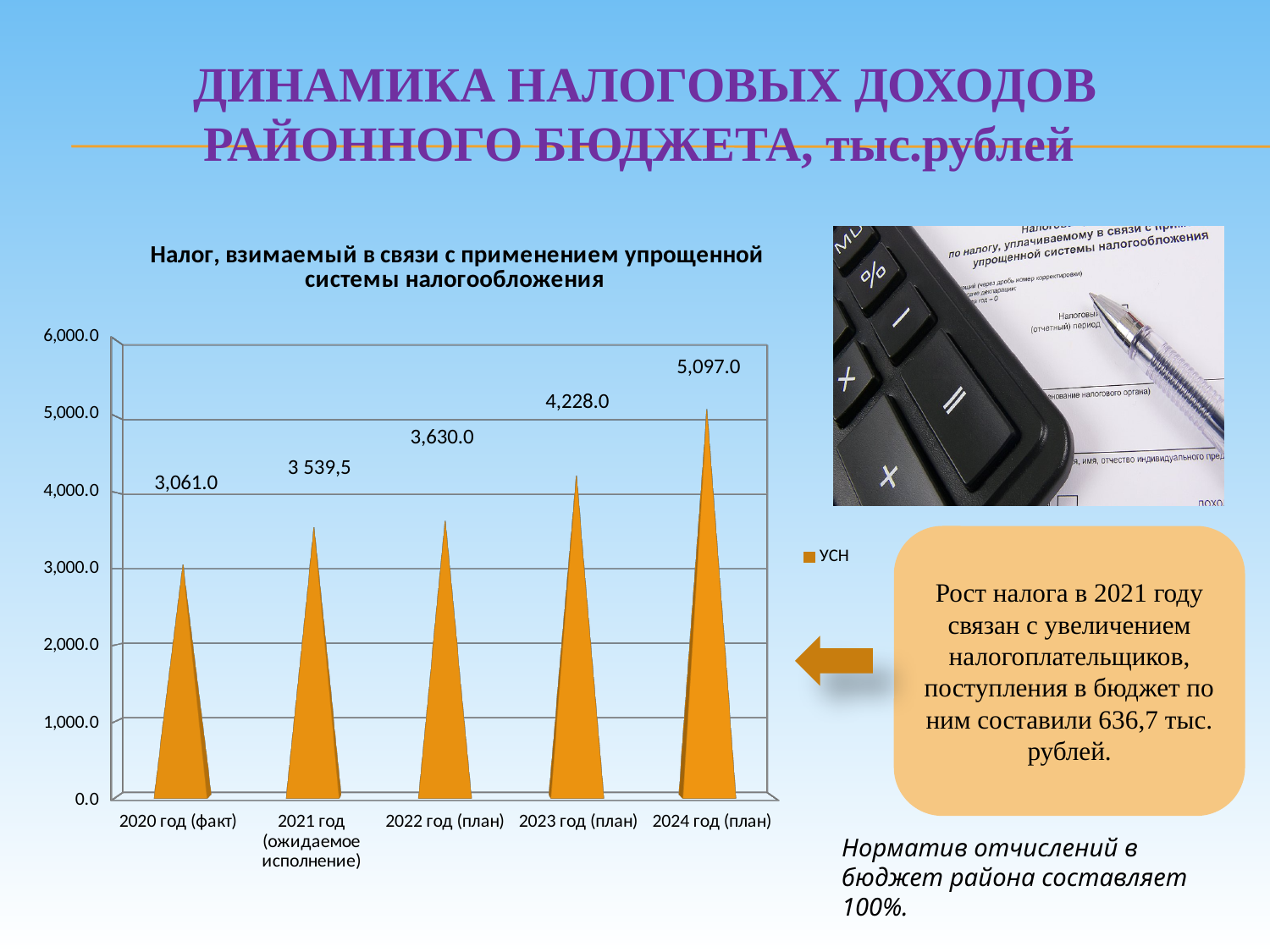
What series name is shown in the chart legend? УСН How many years are shown on the chart? 5 What is the difference between the values for 2022 год (план) and 2020 год (факт)? 569.0 Which year has the highest value? 2024 год (план) What is the value for 2022 год (план)? 3,630.0 What is the value for 2020 год (факт)? 3,061.0 Which is larger, the value for 2023 год (план) or 2022 год (план)? 2023 год (план) What is the difference between the values for 2024 год (план) and 2023 год (план)? 869.0 What is the value for 2021 год (ожидаемое исполнение)? 3 539,5 Do the values rise or fall from 2020 to 2024? rise What is the value for 2024 год (план)? 5,097.0 Which year has the lowest value? 2020 год (факт)